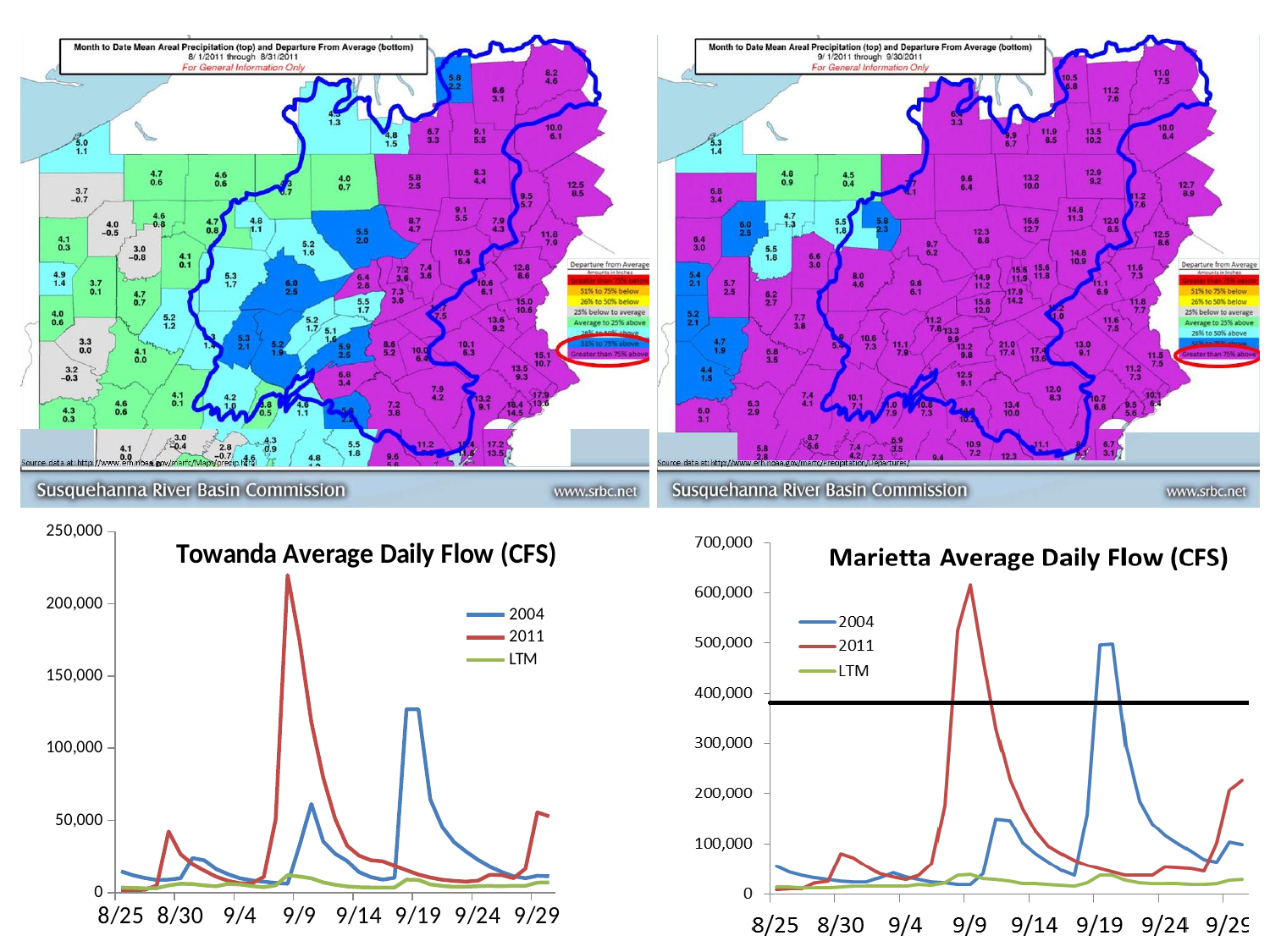
On the Marietta Average Daily Flow (CFS) chart, which has the larger peak, the 2004 series or the 2011 series? 2011 On the Marietta Average Daily Flow (CFS) chart, does the 2011 series rise or fall between 9/9 and 9/14? fall On the Marietta Average Daily Flow (CFS) chart, is the peak value of the 2004 series greater or less than 400,000? greater What kind of chart is the Towanda Average Daily Flow (CFS) chart? line chart On the Towanda Average Daily Flow (CFS) chart, is the peak value of the 2004 series greater or less than 150,000? less On the Towanda Average Daily Flow (CFS) chart, which series reaches the highest peak? 2011 On the Marietta Average Daily Flow (CFS) chart, which series reaches the highest peak? 2011 What are the legend entries on the Marietta Average Daily Flow (CFS) chart? 2004, 2011, LTM On the Towanda Average Daily Flow (CFS) chart, is the peak value of the 2011 series greater or less than 200,000? greater How many series does the legend of the Towanda Average Daily Flow (CFS) chart list? 3